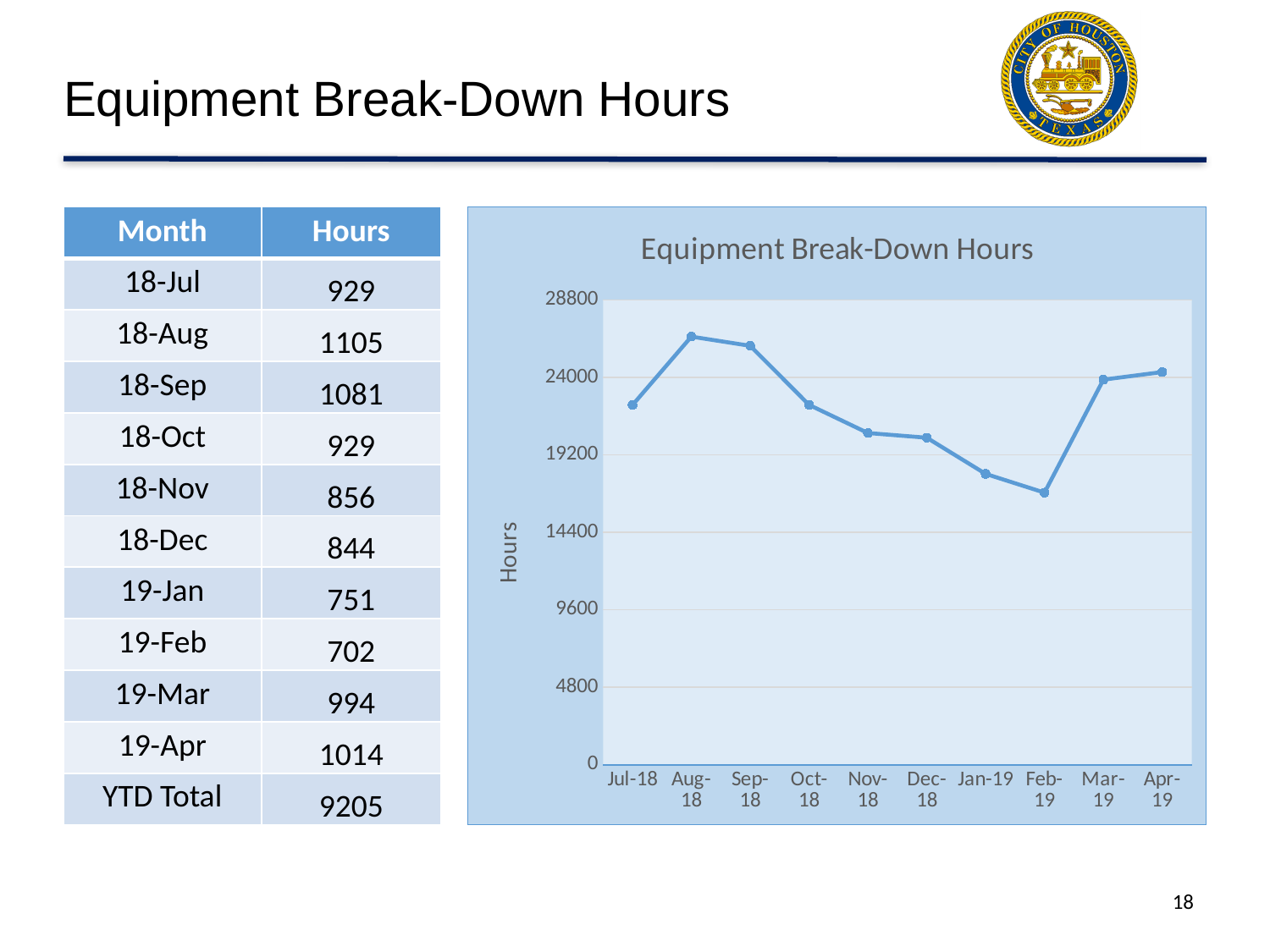
Which month has the lowest value on the chart? Feb-19 Is the value for Jul-18 greater or less than 19200? greater Is the value for Aug-18 greater or less than 24000? greater Is the value for Jan-19 greater or less than 19200? less How many months are plotted on the chart's x axis? 10 Do the values rise or fall from Aug-18 to Feb-19? fall Which is larger on the chart, the value for Mar-19 or the value for Dec-18? Mar-19 What is the title of the chart? Equipment Break-Down Hours What kind of chart is shown on the slide? line chart What is the label on the vertical axis of the chart? Hours Which month has the highest value on the chart? Aug-18